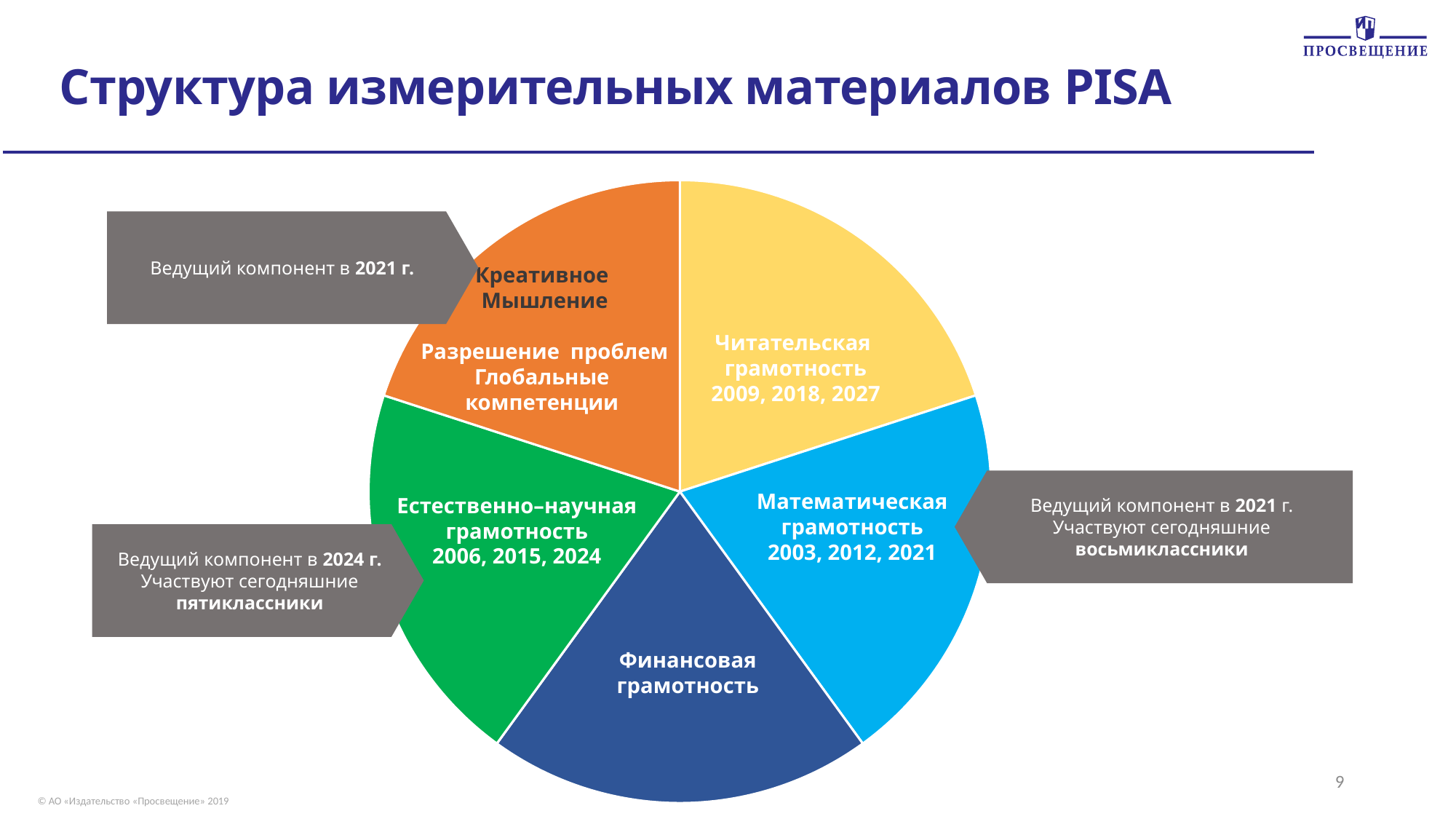
What colour is the Финансовая грамотность slice? Dark blue What kind of chart is shown on the slide? Pie chart Which years are printed on the Читательская грамотность slice? 2009, 2018, 2027 How many slices does the pie chart have? 5 Which slice is labelled with the years 2003, 2012, 2021? Математическая грамотность Which slice of the pie chart is coloured orange? Креативное мышление / Разрешение проблем / Глобальные компетенции Which years are printed on the Естественно-научная грамотность slice? 2006, 2015, 2024 Which years are printed on the Математическая грамотность slice? 2003, 2012, 2021